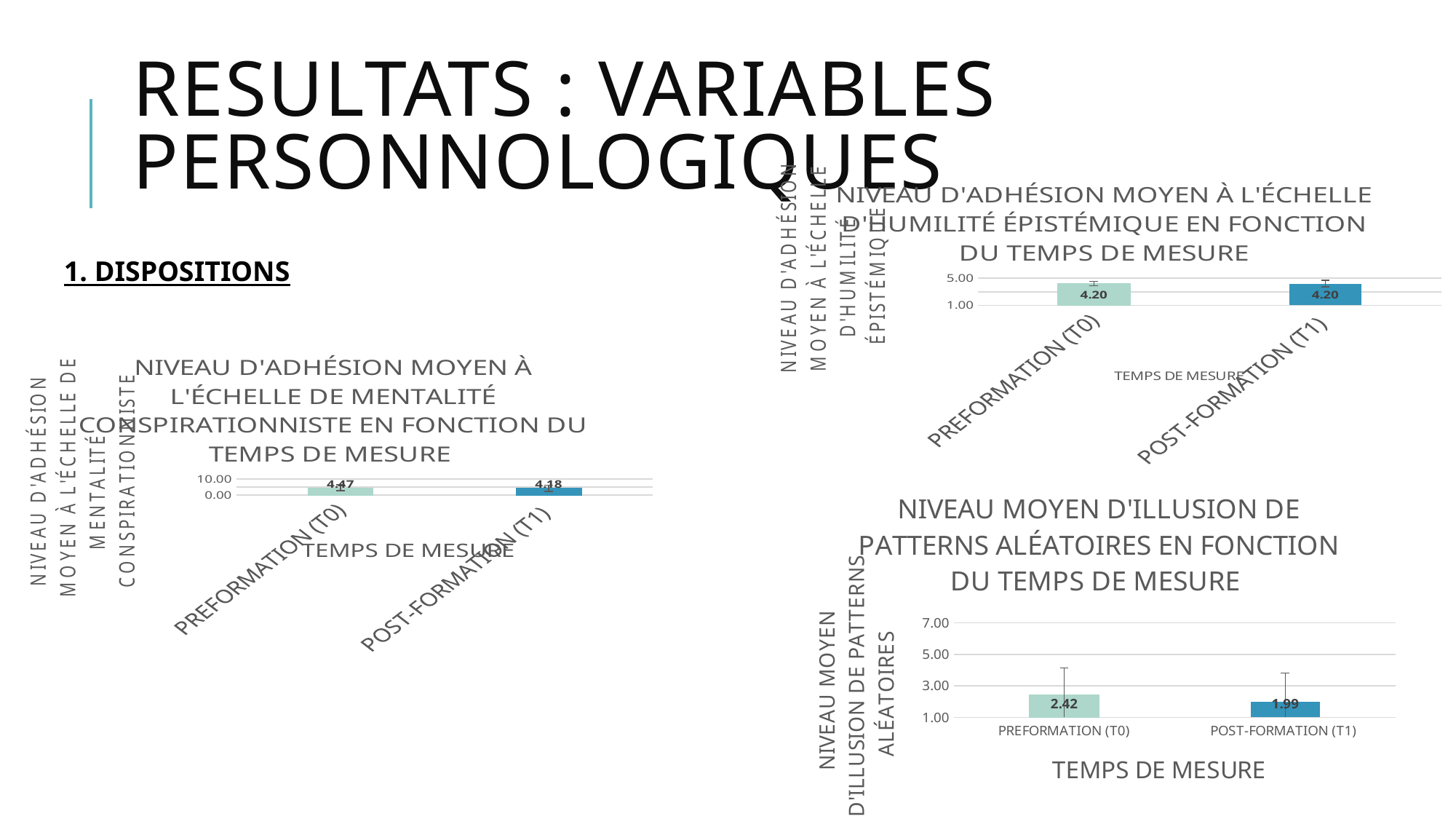
In the chart about illusion of random patterns (bottom right), do the values rise or fall from T0 to T1? fall In the chart about the conspiracy mentality scale (bottom left), what is the value for PREFORMATION (T0)? 4.47 How many categories are shown on the x axis of the chart about illusion of random patterns (bottom right)? 2 In the chart about illusion of random patterns (bottom right), what is the value for PREFORMATION (T0)? 2.42 What kind of chart is the chart about the epistemic humility scale (top right)? bar chart In the chart about the conspiracy mentality scale (bottom left), what is the value for POST-FORMATION (T1)? 4.18 In the chart about illusion of random patterns (bottom right), which time of measurement has the higher value? PREFORMATION (T0) In the chart about illusion of random patterns (bottom right), what is the difference between the T0 and T1 values? 0.43 In the chart about the conspiracy mentality scale (bottom left), what is the difference between the T0 and T1 values? 0.29 In the chart about illusion of random patterns (bottom right), what is the value for POST-FORMATION (T1)? 1.99 In the chart about the epistemic humility scale (top right), what is the value for POST-FORMATION (T1)? 4.20 In the chart about the epistemic humility scale (top right), is the value for PREFORMATION (T0) greater or less than 5.00? less